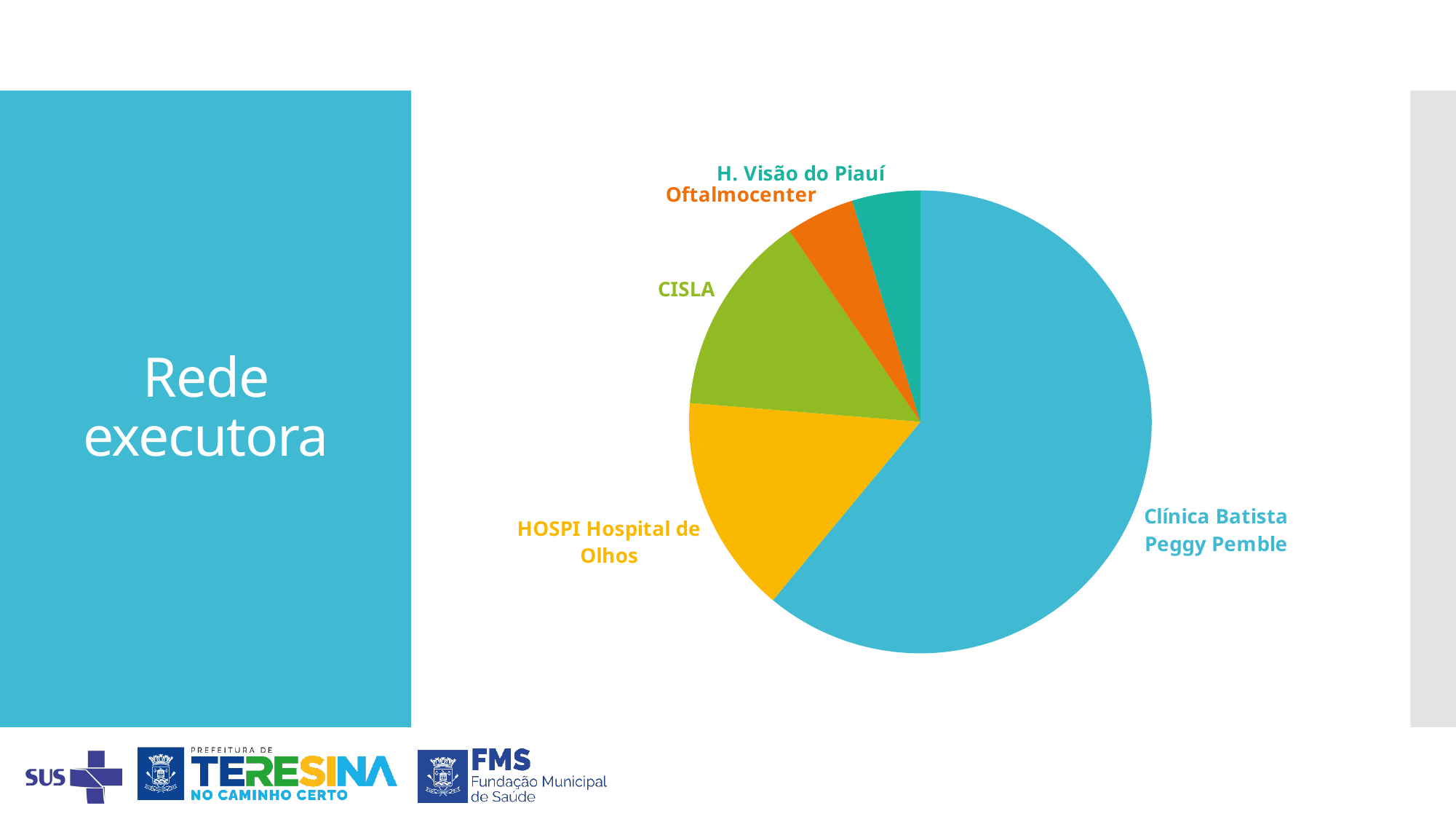
What is the title text shown on the left panel of the slide? Rede executora Which slice is larger, CISLA or Oftalmocenter? CISLA Which slice is larger, Clínica Batista Peggy Pemble or CISLA? Clínica Batista Peggy Pemble What kind of chart is shown on the slide? Pie chart Which slice is larger, Clínica Batista Peggy Pemble or HOSPI Hospital de Olhos? Clínica Batista Peggy Pemble Which category has the largest slice in the pie chart? Clínica Batista Peggy Pemble How many slices does the pie chart have? 5 What colour is the CISLA slice in the pie chart? Green